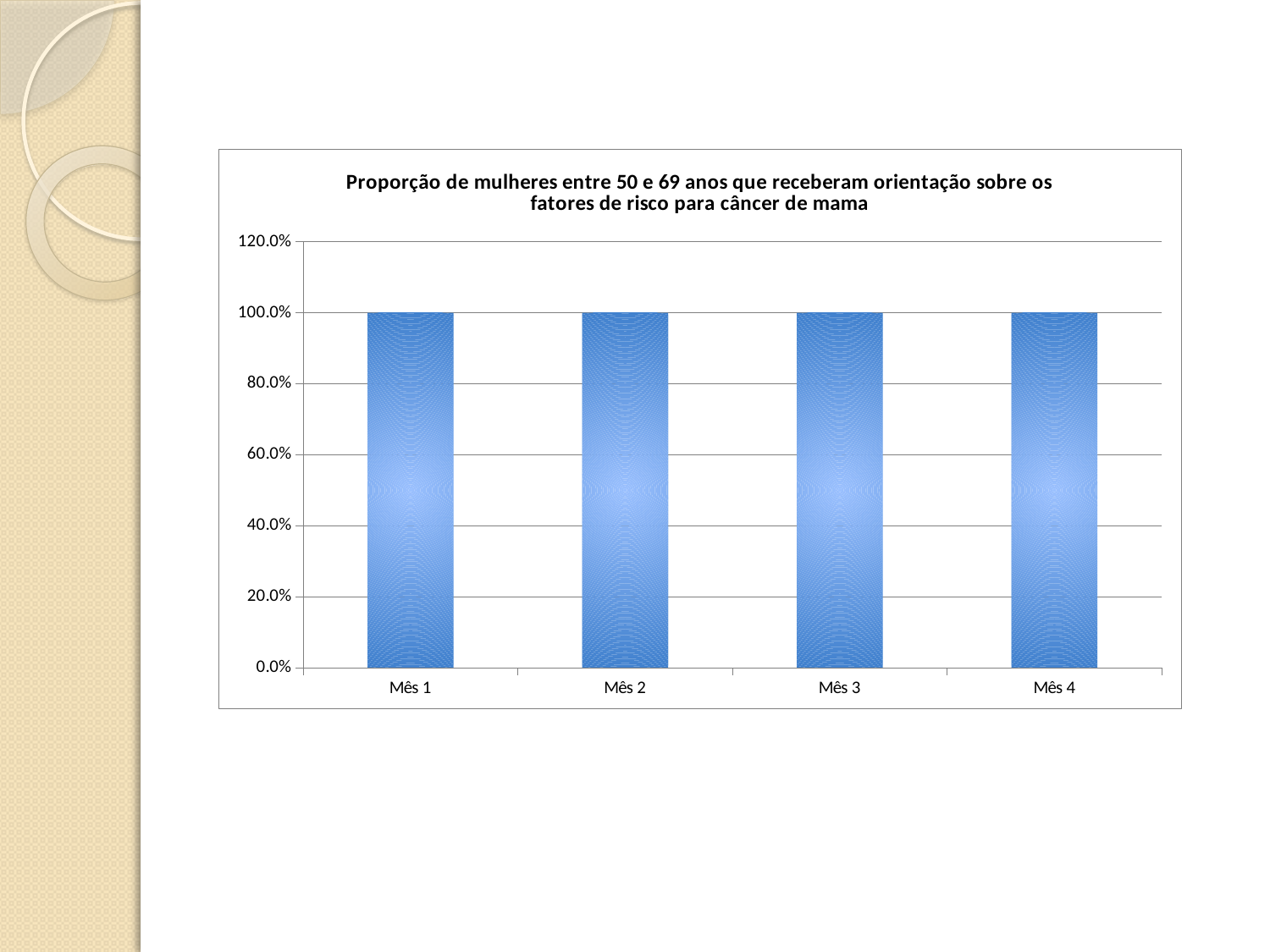
What is the title of the chart? Proporção de mulheres entre 50 e 69 anos que receberam orientação sobre os fatores de risco para câncer de mama What is the difference between the values for Mês 1 and Mês 4? 0.0% Do the values rise, fall, or stay the same from Mês 1 to Mês 4? stay the same What is the value for Mês 1? 100.0% What is the highest value shown on the vertical axis? 120.0% What is the value for Mês 3? 100.0% What kind of chart is shown on the slide? bar chart What is the value for Mês 4? 100.0% Is the value for Mês 4 greater or less than 120.0%? less Is the value for Mês 2 greater or less than 80.0%? greater How many categories (months) are plotted on the chart? 4